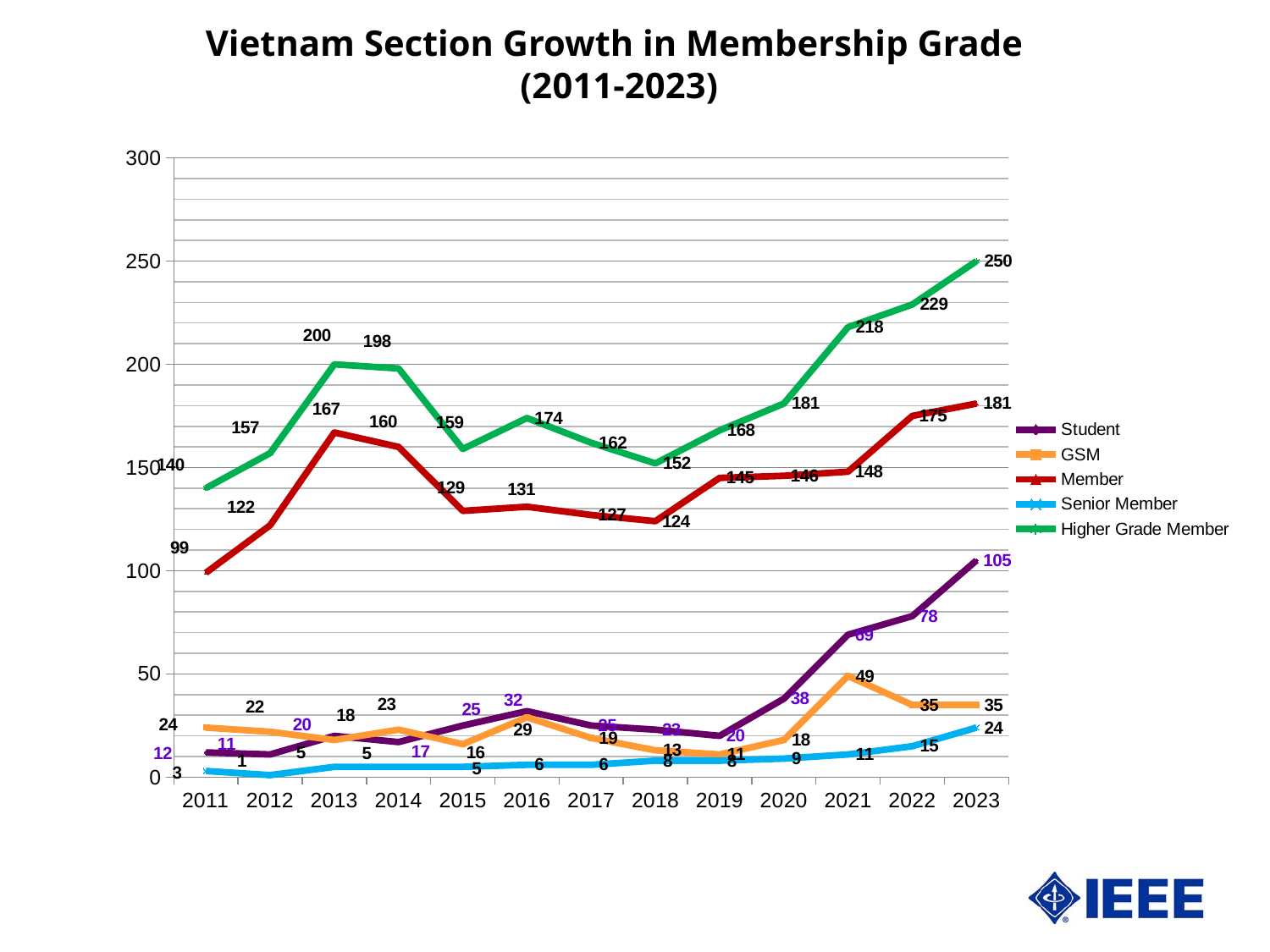
What is the GSM value in 2021? 49 In which year is the Senior Member value lowest? 2012 Which series has the larger value in 2016, Student or GSM? Student What is the Higher Grade Member value in 2023? 250 In which year does the Higher Grade Member series reach its highest value? 2023 How many series does the legend list? 5 What is the Member value in 2011? 99 What is the difference between the Higher Grade Member value and the Member value in 2023? 69 What type of chart is shown on the slide? line chart How many years are plotted along the x axis? 13 What is the Student value in 2021? 69 Is the Member value in 2022 greater or less than 150? greater